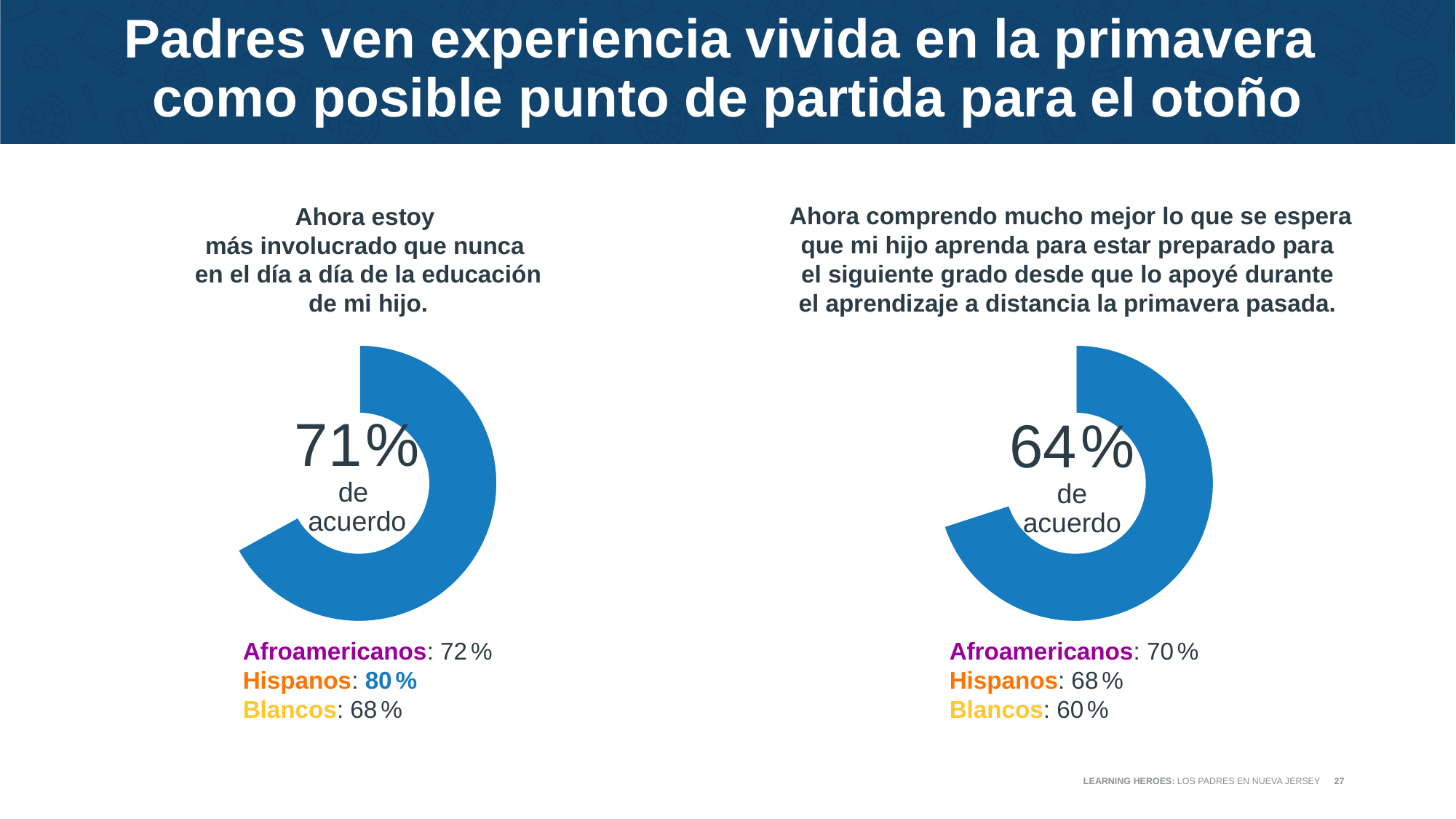
On the left chart, which group has the highest percentage of agreement? Hispanos On the left chart, what percentage of Hispanos agree? 80% On the right chart, what percentage of parents agree with the statement about better understanding what their child is expected to learn? 64% On the left chart, what percentage of parents agree with the statement about being more involved in their child's education? 71% On the left chart, what is the difference in percentage points between Hispanos (80%) and Blancos (68%)? 12 percentage points Which chart shows a higher percentage of agreement, the left one or the right one? left What kind of chart is used on this slide to show the percentage of parents who agree? donut (pie) chart What is the difference in percentage points between the agreement shown on the left chart (71%) and the right chart (64%)? 7 percentage points On the right chart, which group has the lowest percentage of agreement? Blancos On the right chart, what percentage of Blancos agree? 60% How many demographic groups are listed below each chart? 3